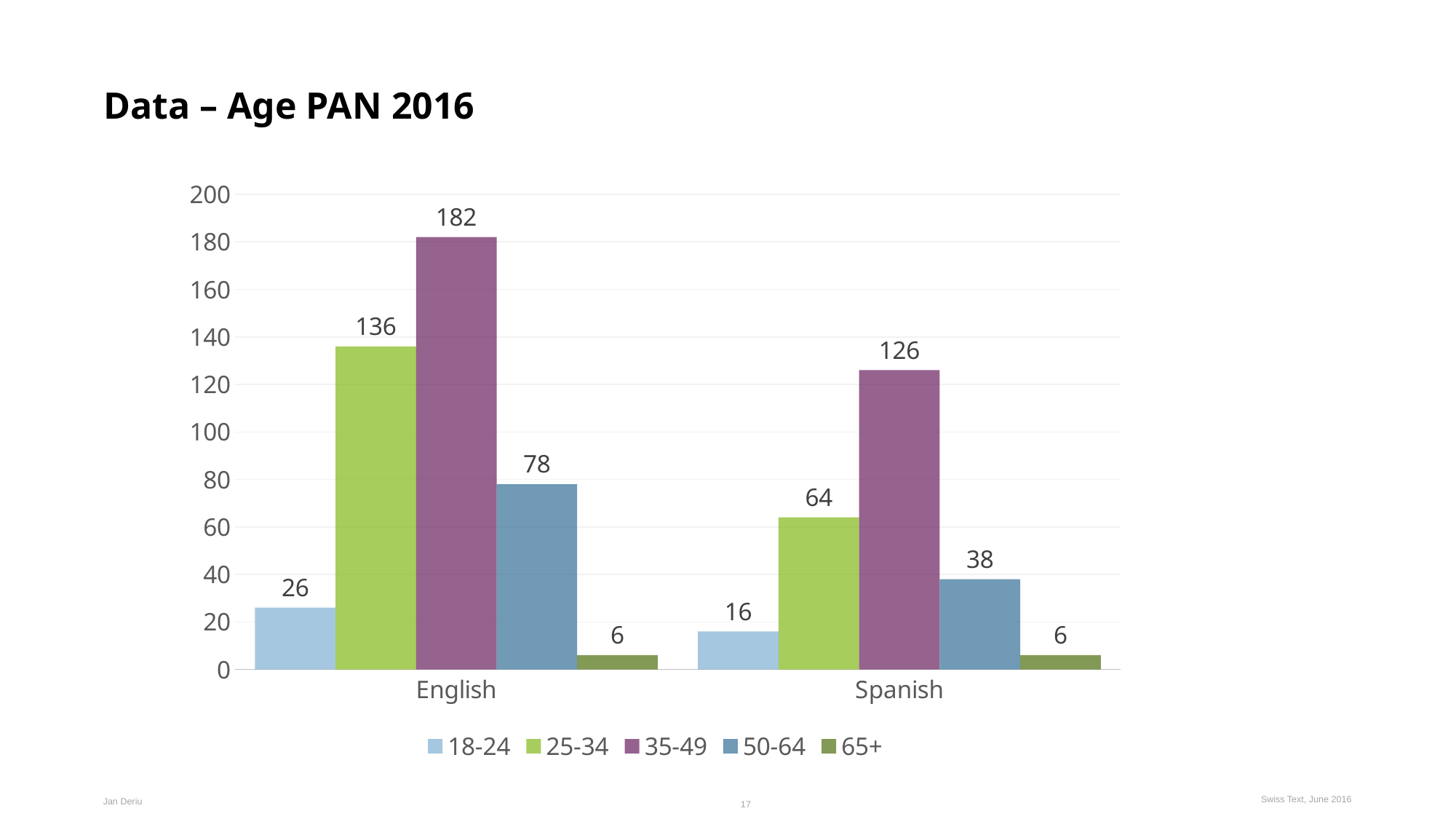
How many series does the legend list? 5 What is the value for the 35-49 age group in English? 182 What is the value for the 18-24 age group in English? 26 How many language categories are shown on the x axis? 2 What kind of chart is shown on the slide? Bar chart What is the total of all age group values for Spanish? 250 Which age group has the lowest value for English? 65+ Which is larger: the 50-64 value for English or the 50-64 value for Spanish? English What is the difference between the 35-49 values for English and Spanish? 56 What is the value for the 25-34 age group in Spanish? 64 Which age group has the highest value for Spanish? 35-49 What is the title of the slide? Data – Age PAN 2016